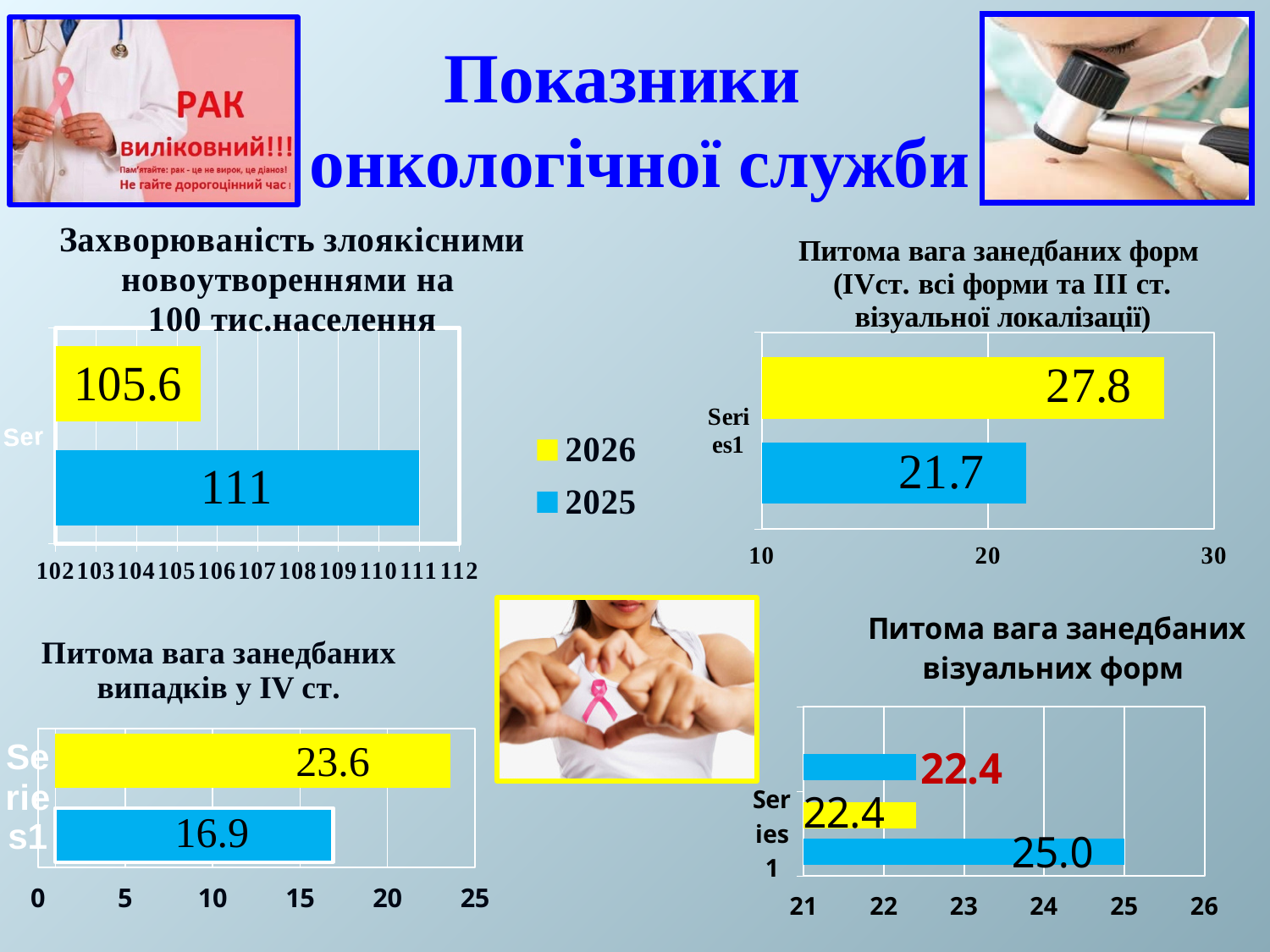
In the chart titled "Питома вага занедбаних випадків у IV ст.", what value is shown on the yellow bar? 23.6 In the top-right chart titled "Питома вага занедбаних форм", what value is shown on the blue bar? 21.7 In the top-right chart titled "Питома вага занедбаних форм", which bar is larger, the yellow one or the blue one? the yellow one In the chart titled "Захворюваність злоякісними новоутвореннями на 100 тис.населення", what value is shown on the blue bar? 111 In the chart titled "Захворюваність злоякісними новоутвореннями на 100 тис.населення", what is the difference between the blue bar and the yellow bar? 5.4 Which two years are listed in the legend in the middle of the slide? 2026 and 2025 In the top-right chart titled "Питома вага занедбаних форм", what value is shown on the yellow bar? 27.8 How many bars are plotted in the bottom-right chart titled "Питома вага занедбаних візуальних форм"? 3 In the chart titled "Питома вага занедбаних випадків у IV ст.", what is the difference between the yellow bar and the blue bar? 6.7 In the bottom-right chart titled "Питома вага занедбаних візуальних форм", what value is shown on the bottom blue bar? 25.0 In the chart titled "Питома вага занедбаних випадків у IV ст.", what value is shown on the blue bar? 16.9 In the chart titled "Захворюваність злоякісними новоутвореннями на 100 тис.населення", what value is shown on the yellow bar? 105.6